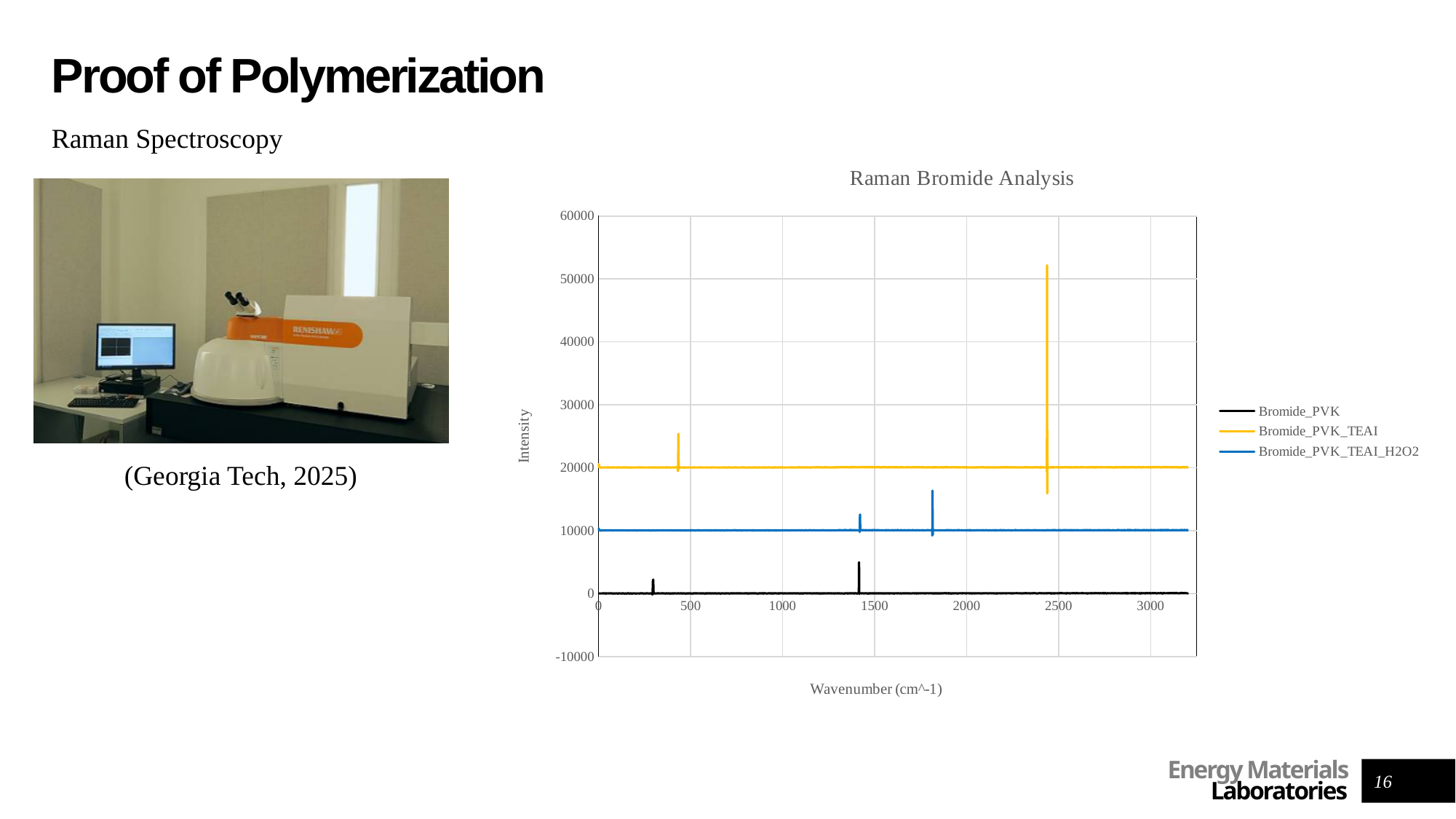
Is the tallest peak of the Bromide_PVK series greater or less than 10000? less At what intensity level does the flat baseline of the Bromide_PVK_TEAI_H2O2 series sit? 10000 Which series reaches the highest intensity on the chart? Bromide_PVK_TEAI Which series has the lowest baseline intensity on the chart? Bromide_PVK At what intensity level does the flat baseline of the Bromide_PVK_TEAI series sit? 20000 Is the tallest peak of the Bromide_PVK_TEAI series greater or less than 40000? greater What is the title of the chart on the slide? Raman Bromide Analysis What is the label of the x axis of the chart? Wavenumber (cm^-1) At what intensity level does the flat baseline of the Bromide_PVK series sit? 0 How many series does the legend of the Raman Bromide Analysis chart list? 3 Is the baseline of Bromide_PVK_TEAI higher or lower than the baseline of Bromide_PVK_TEAI_H2O2? higher What kind of chart is shown on the slide? line chart